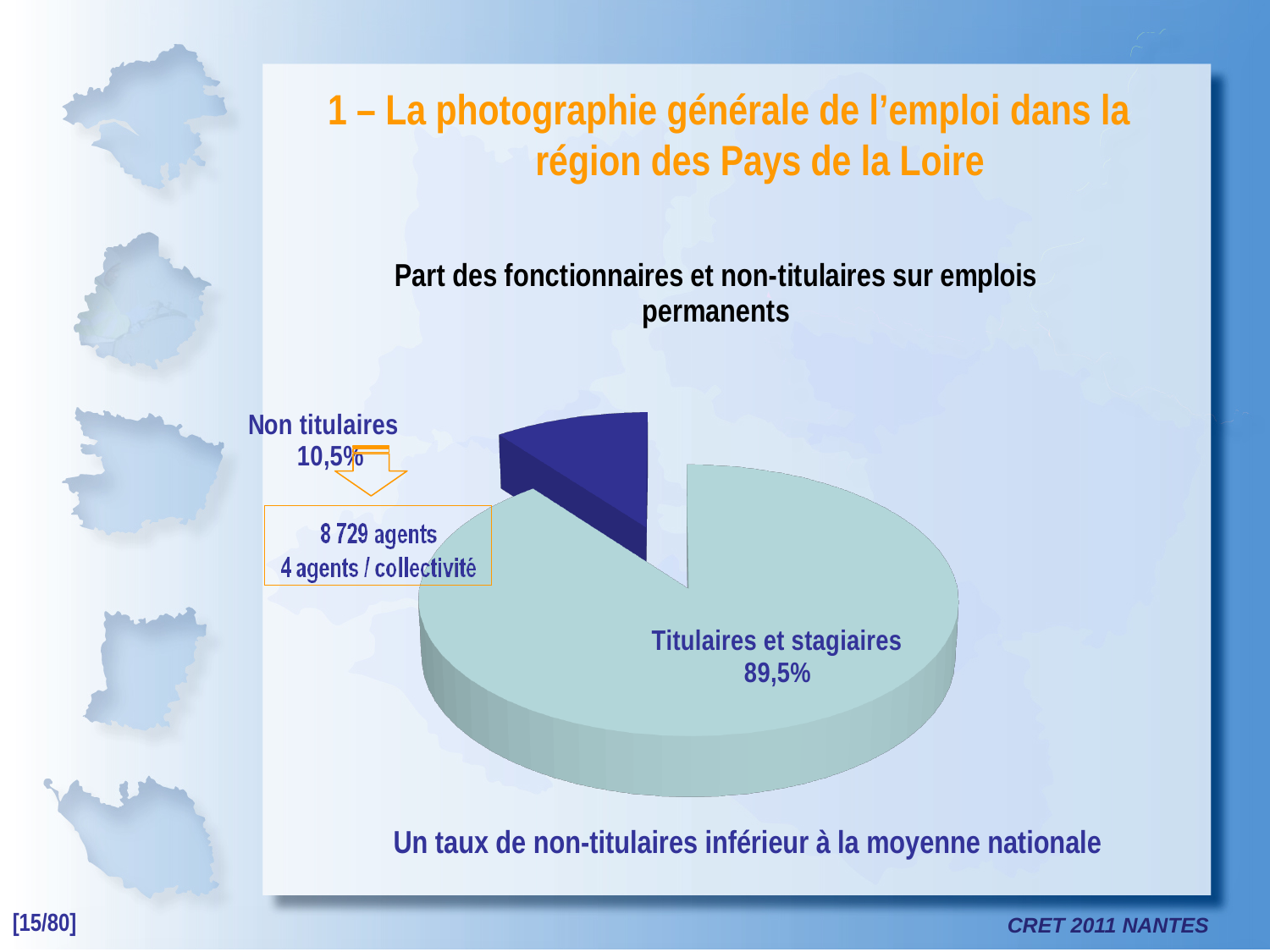
Which category has the smallest share of the pie? Non titulaires What colour is the Non titulaires slice? dark blue What is the title of the pie chart? Part des fonctionnaires et non-titulaires sur emplois permanents What is the share for Titulaires et stagiaires? 89,5% What kind of chart is shown on the slide? pie chart How many agents are reported for Non titulaires? 8 729 agents What is the share for Non titulaires? 10,5% How many Non titulaires agents per collectivité are reported? 4 agents / collectivité Which is larger, the share for Non titulaires or the share for Titulaires et stagiaires? Titulaires et stagiaires Which category has the largest share of the pie? Titulaires et stagiaires What is the difference in percentage points between Titulaires et stagiaires and Non titulaires? 79 percentage points How many slices does the pie chart have? 2